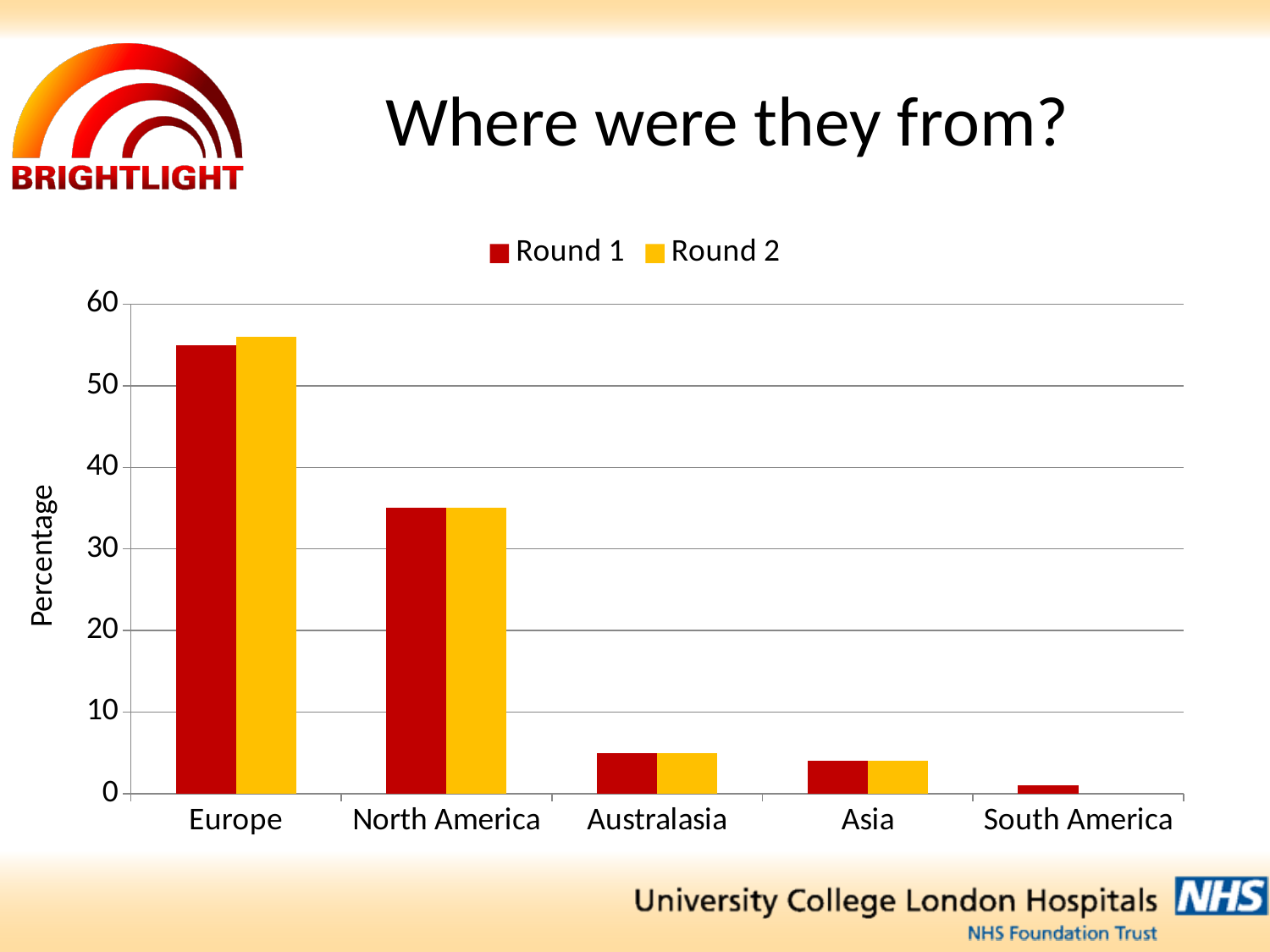
Which region has the highest Round 1 value? Europe Which is larger, the Round 1 value for North America or the Round 1 value for Asia? North America What kind of chart is shown on the slide? bar chart How many regions are shown on the x axis? 5 Is the Round 1 value for North America greater or less than 30? greater Is the Round 2 value for North America greater or less than 40? less What is the label on the y axis? Percentage Which region has the lowest Round 1 value? South America Is the Round 1 value for Europe greater or less than 50? greater How many series does the legend list? 2 What is the title of the chart? Where were they from?